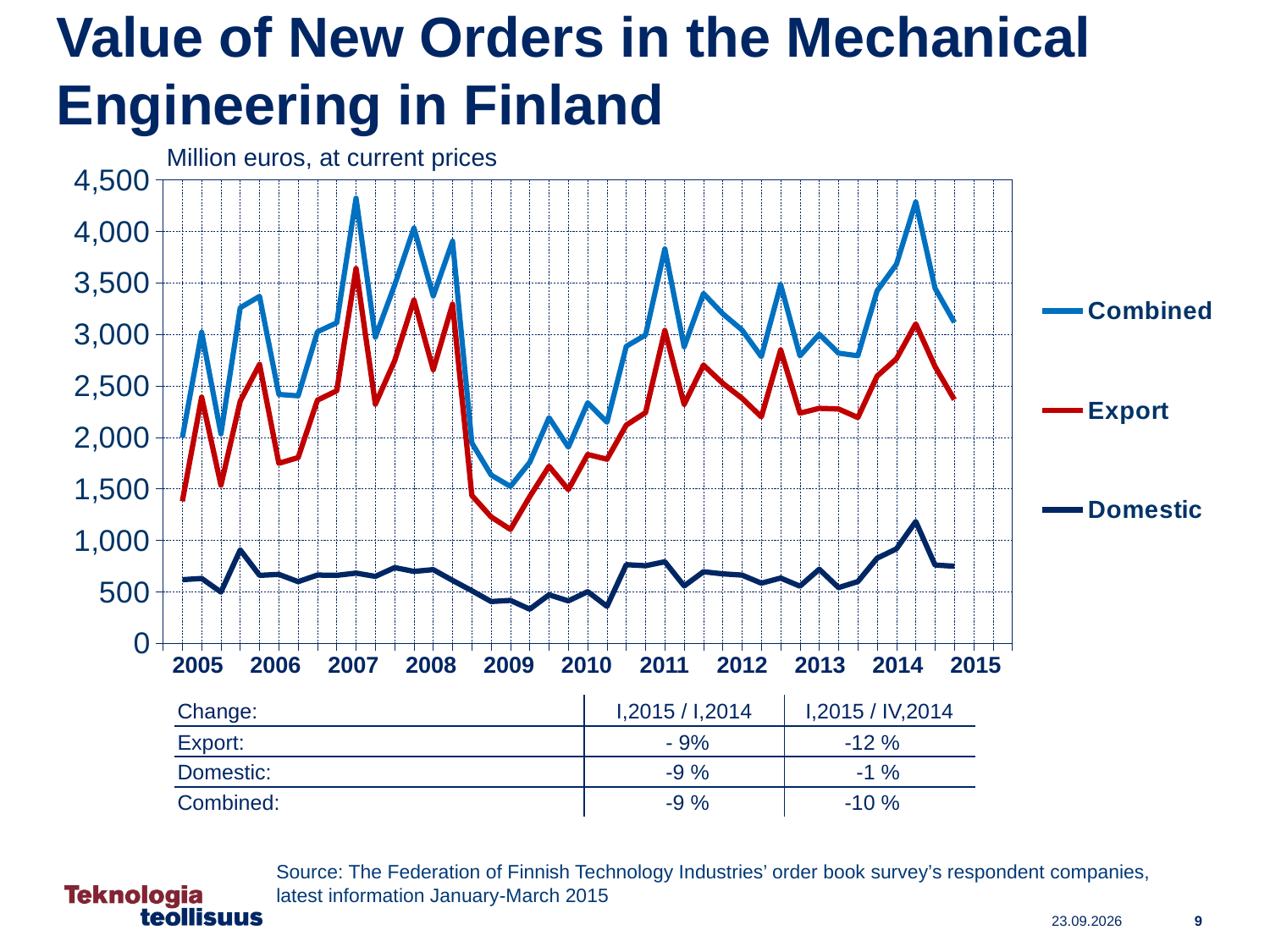
How many series does the legend list? 3 Is the value of the Export series in 2009 greater or less than 1,500? less In 2007, which is larger, the Export series or the Domestic series? Export What unit is stated above the chart? Million euros, at current prices Which series is drawn in red in the chart? Export Is the peak value of the Combined series in 2007 greater or less than 4,000? greater Which series has the highest values throughout the chart? Combined Is the highest value of the Domestic series greater or less than 1,500? less Which series has the lowest values throughout the chart? Domestic What kind of chart is shown on the slide? line chart Does the Combined series rise or fall from 2008 to 2009? fall How many year labels are shown on the x axis? 11